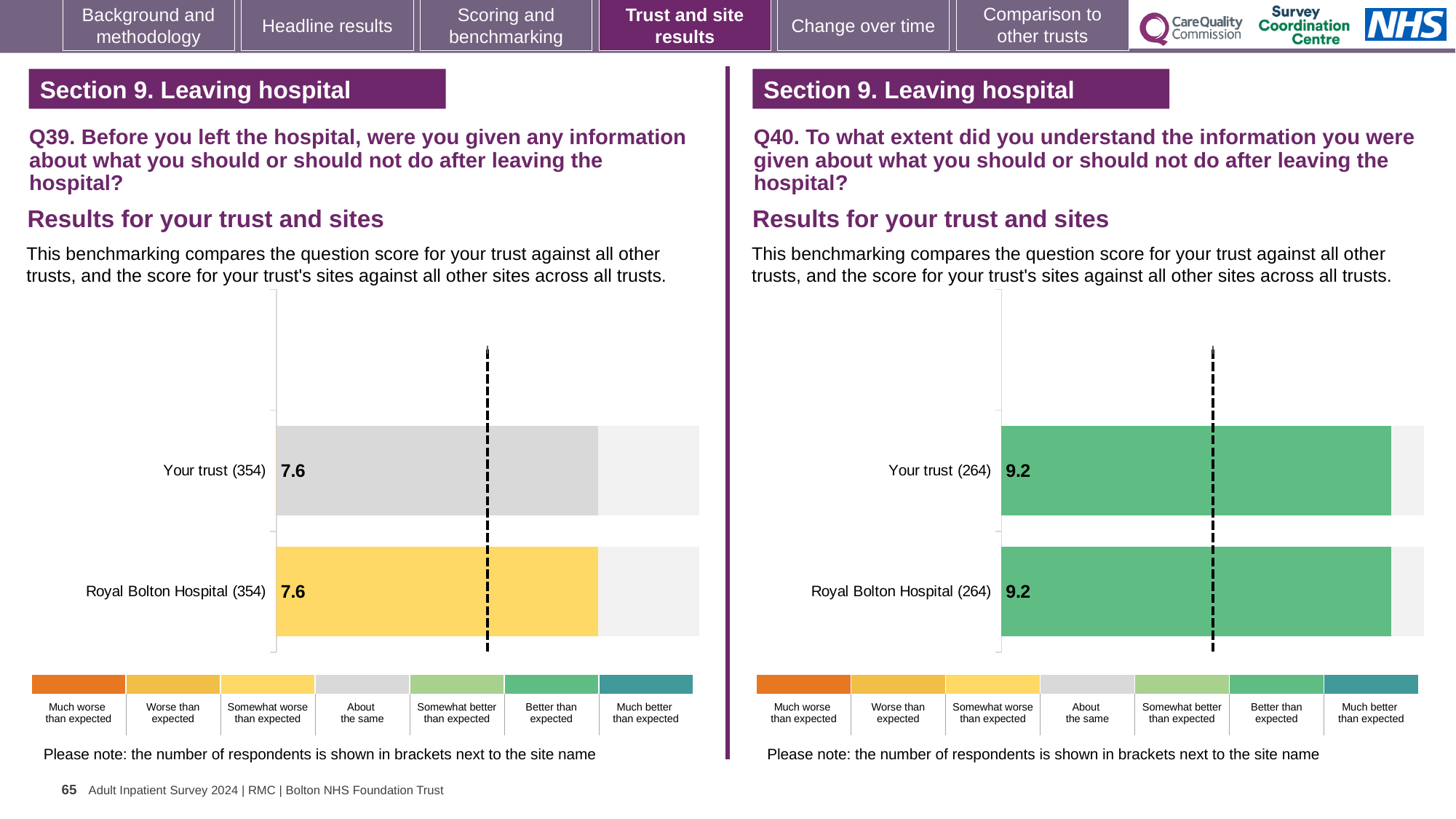
On the Q39 chart (left), what is the score for Royal Bolton Hospital? 7.6 On the Q40 chart (right), what is the score for Royal Bolton Hospital? 9.2 On the Q40 chart (right), what is the score for Your trust? 9.2 On the Q40 chart (right), how many respondents are shown in brackets next to Your trust? 264 Is the score for Your trust on the Q40 chart (right) larger or smaller than the score for Your trust on the Q39 chart (left)? Larger How many bars are plotted on the Q40 chart (right)? 2 How many bars are plotted on the Q39 chart (left)? 2 On the Q39 chart (left), what is the score for Your trust? 7.6 On the Q40 chart (right), what is the difference between the score for Your trust and the score for Royal Bolton Hospital? 0 What kind of chart is the Q40 chart (right)? Bar chart On the Q39 chart (left), how many respondents are shown in brackets next to Royal Bolton Hospital? 354 On the Q39 chart (left), what is the difference between the score for Your trust and the score for Royal Bolton Hospital? 0